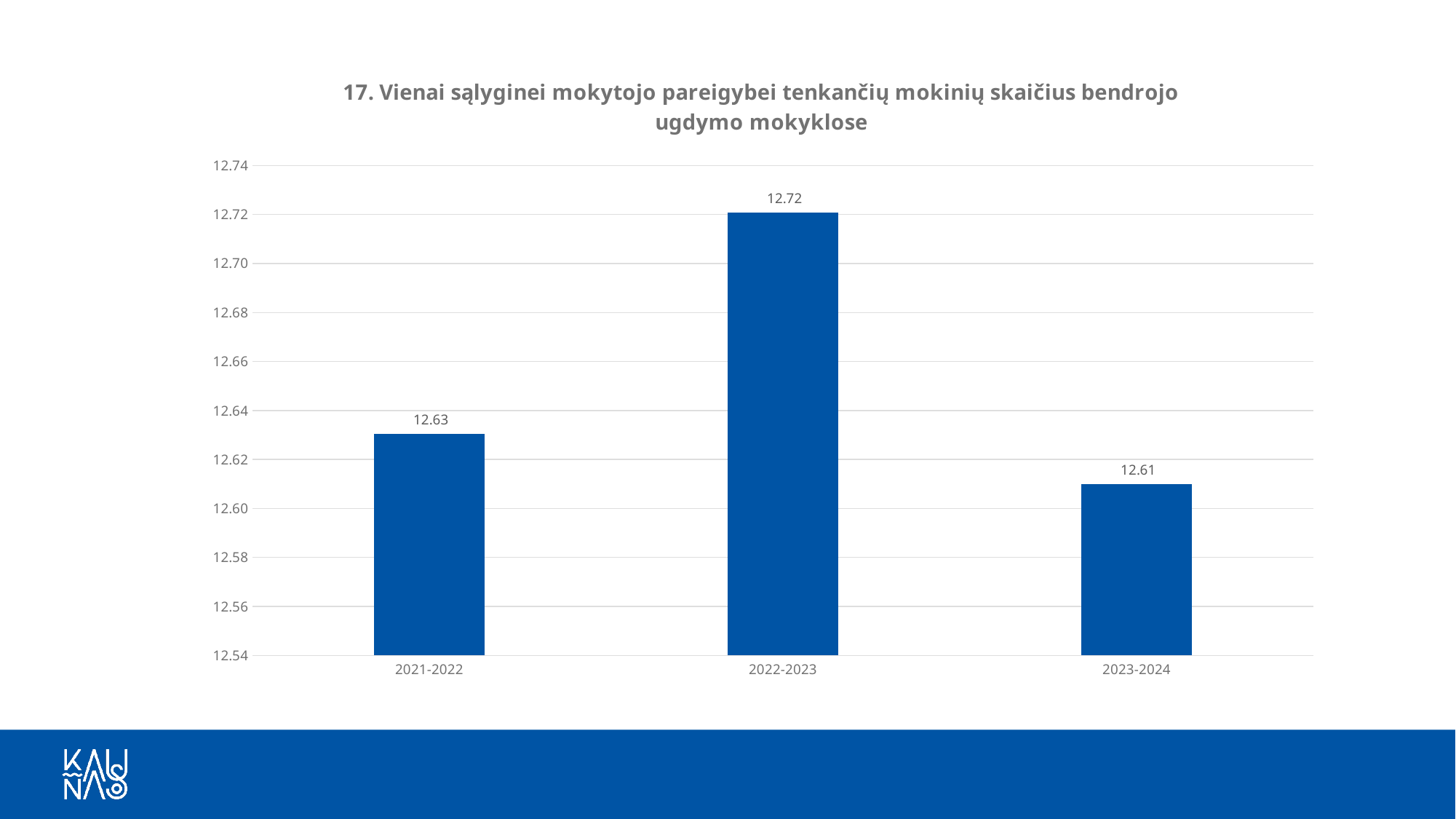
Is the value for 2022-2023 greater or less than 12.70? greater Which is larger, the value for 2021-2022 or the value for 2023-2024? 2021-2022 What is the value for 2022-2023? 12.72 What is the value for 2021-2022? 12.63 What is the value for 2023-2024? 12.61 What is the difference between the values for 2021-2022 and 2023-2024? 0.02 Which school year has the lowest value? 2023-2024 What is the difference between the values for 2022-2023 and 2021-2022? 0.09 What kind of chart is shown on the slide? bar chart How many school years are shown on the chart? 3 Does the value rise or fall from 2022-2023 to 2023-2024? fall Which school year has the highest value? 2022-2023